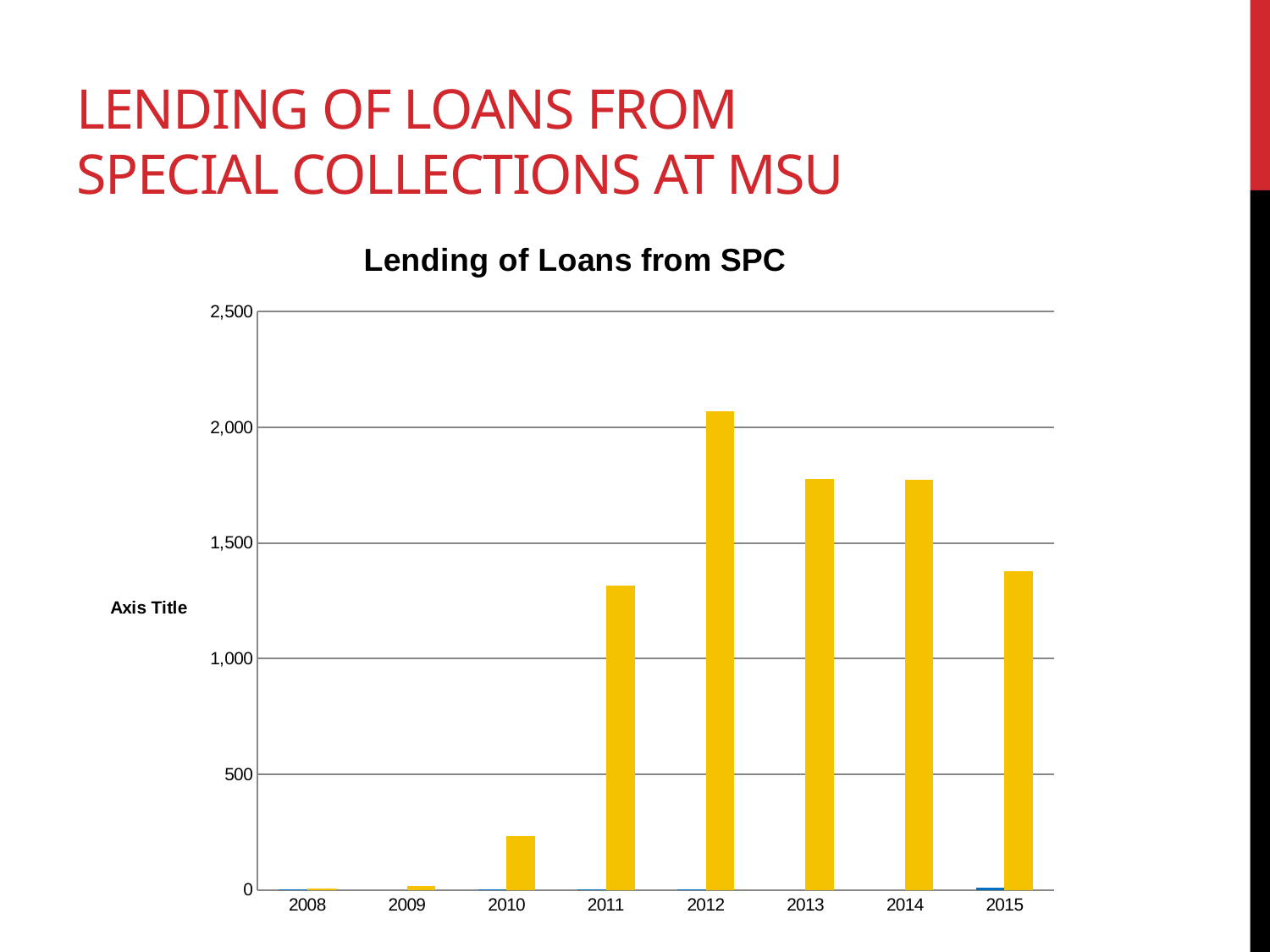
Is the value for 2011 greater or less than 1,500? less What is the title of the chart? Lending of Loans from SPC How many years are shown on the x axis of the chart? 8 Is the value for 2010 greater or less than 500? less Is the value for 2015 greater or less than 1,000? greater What kind of chart is shown on the slide? bar chart Do the values rise or fall from 2008 to 2012? rise Which year has the highest value in the chart? 2012 Which year has the larger value, 2012 or 2013? 2012 Which year has the larger value, 2011 or 2015? 2015